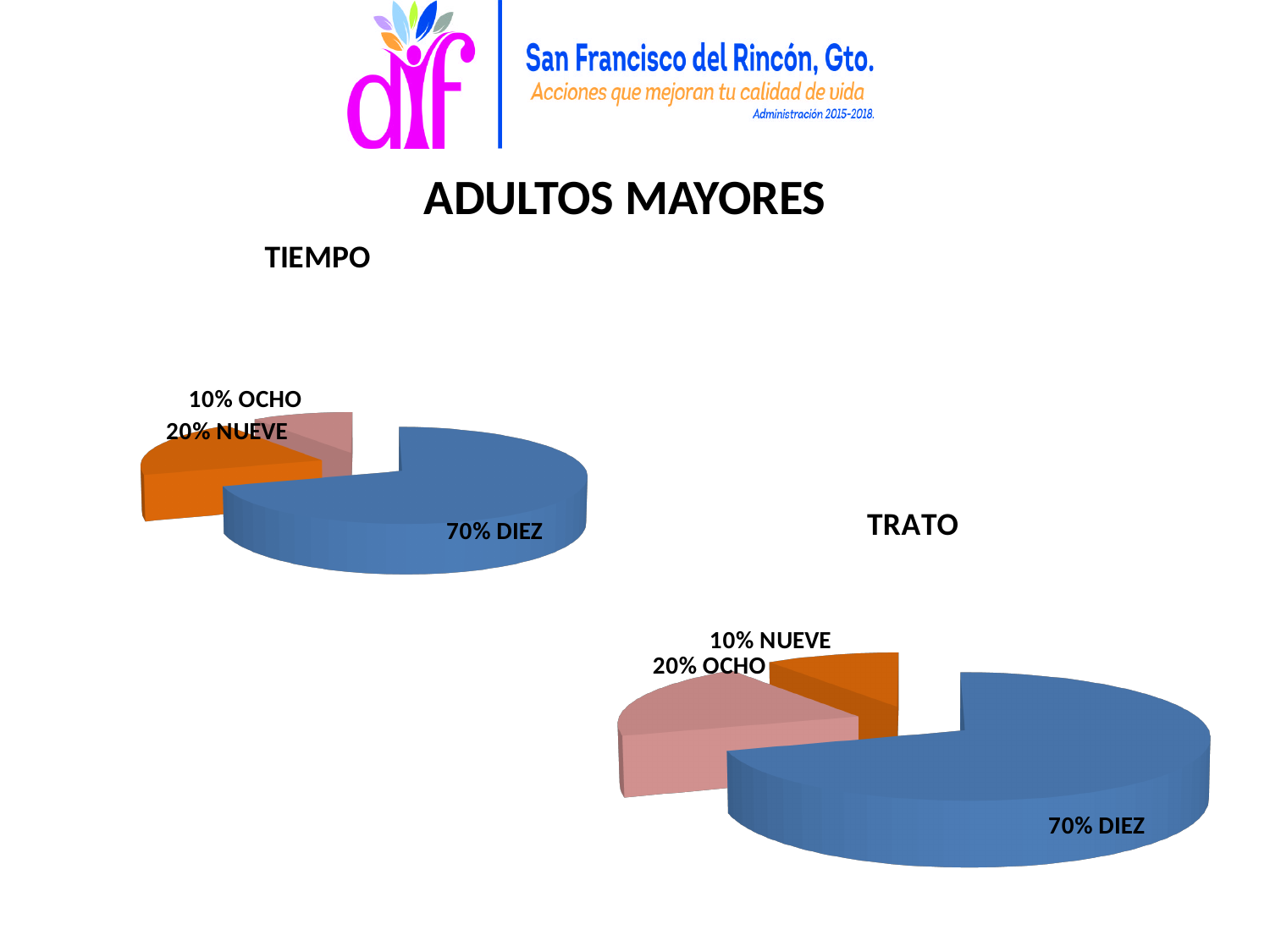
In the TIEMPO chart, what share does DIEZ have? 70% In the TIEMPO chart, which category has the smallest slice? OCHO In the TRATO chart, which category has the largest slice? DIEZ In the TIEMPO chart, what share does NUEVE have? 20% In the TRATO chart, what share does OCHO have? 20% In the TRATO chart, which is larger, OCHO or NUEVE? OCHO In the TRATO chart, which category has the smallest slice? NUEVE How many slices does the TIEMPO chart have? 3 In the TIEMPO chart, what is the difference in percentage points between DIEZ and NUEVE? 50 What type of chart is the TRATO chart? Pie chart